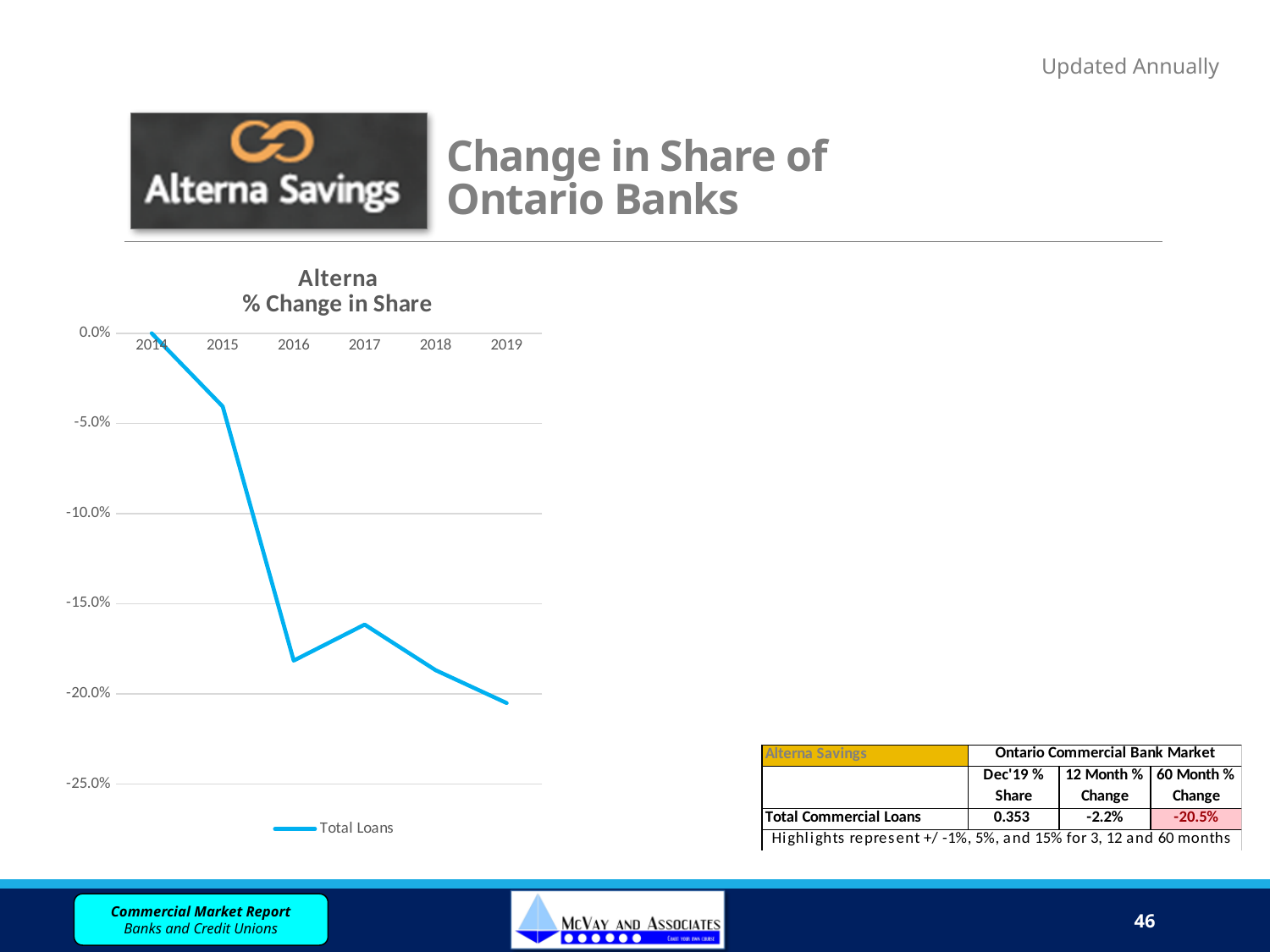
Is the value for Total Loans in 2018 greater or less than -20.0%? greater How many series does the chart legend list? 1 How many years are plotted along the x axis of the chart? 6 Which year has the higher Total Loans value, 2016 or 2017? 2017 Do the Total Loans values generally rise or fall from 2014 to 2019? fall What is the name of the series shown in the chart legend? Total Loans Which year has the lowest value for Total Loans in the chart? 2019 Is the value for Total Loans in 2015 greater or less than -10.0%? greater What is the title of the chart? Alterna % Change in Share Is the value for Total Loans in 2016 greater or less than -15.0%? less Which year has the highest value for Total Loans in the chart? 2014 What kind of chart is shown on the slide? line chart